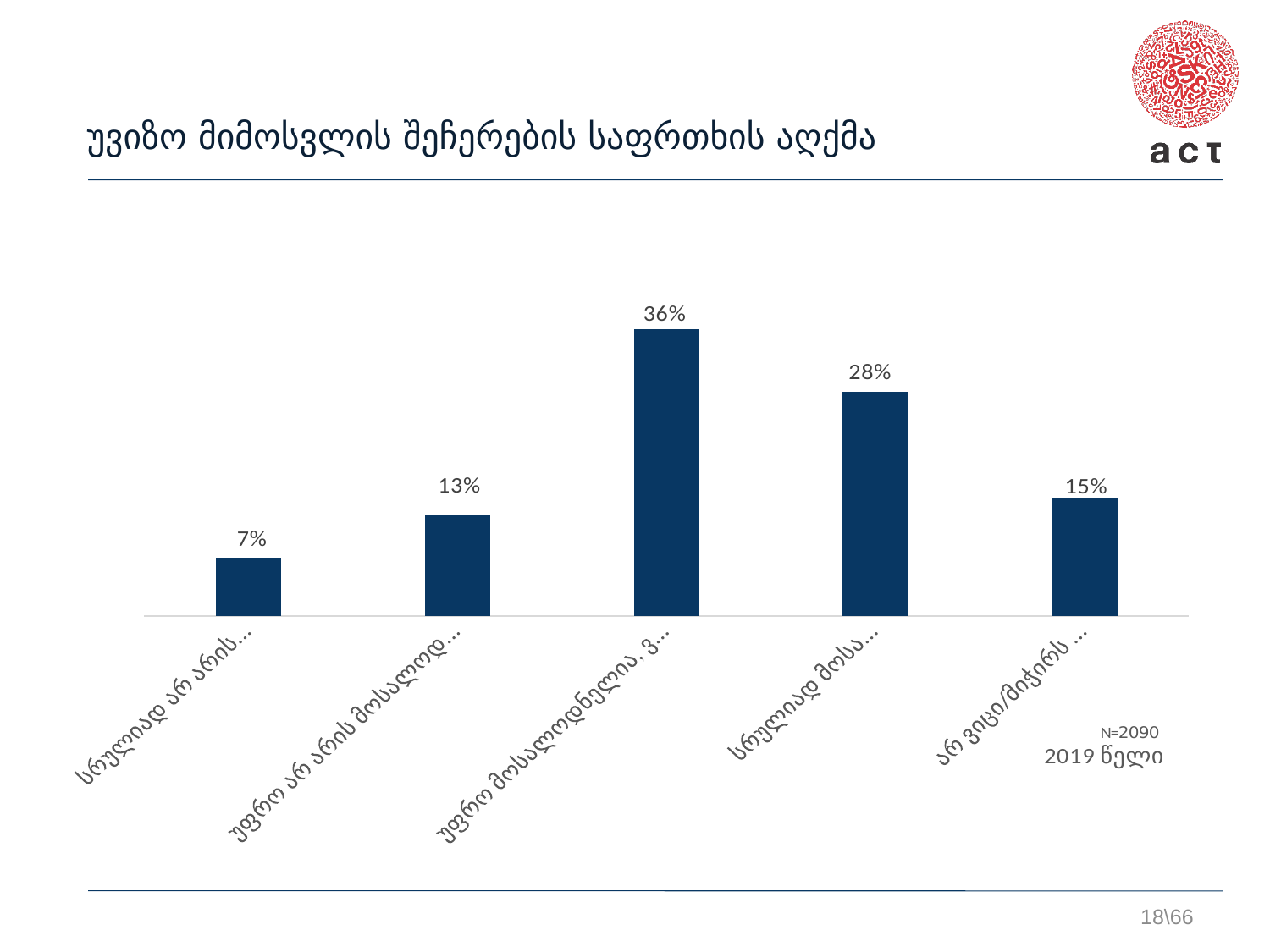
What is the value of the fourth bar from the left (label beginning "სრულიად მოსა")? 28% How many bars (categories) does the chart show? 5 What is the difference between the third bar (36%) and the fourth bar (28%)? 8% What is the value of the second bar from the left (label beginning "უფრო არ არის მოსალოდ")? 13% Which is larger: the value of the second bar or the value of the last bar? the last bar (15%) Which bar has the highest value? the third bar (უფრო მოსალოდნელია...), 36% What sample size (N) is stated on the slide? N=2090 What type of chart is shown on the slide? bar chart Which bar has the lowest value? the first bar (სრულიად არ არის...), 7% What is the value of the first bar from the left (label beginning "სრულიად არ არის")? 7% What is the value of the middle (third) bar (label beginning "უფრო მოსალოდნელია")? 36% What is the value of the last bar on the right (label beginning "არ ვიცი/მიჭირს")? 15%